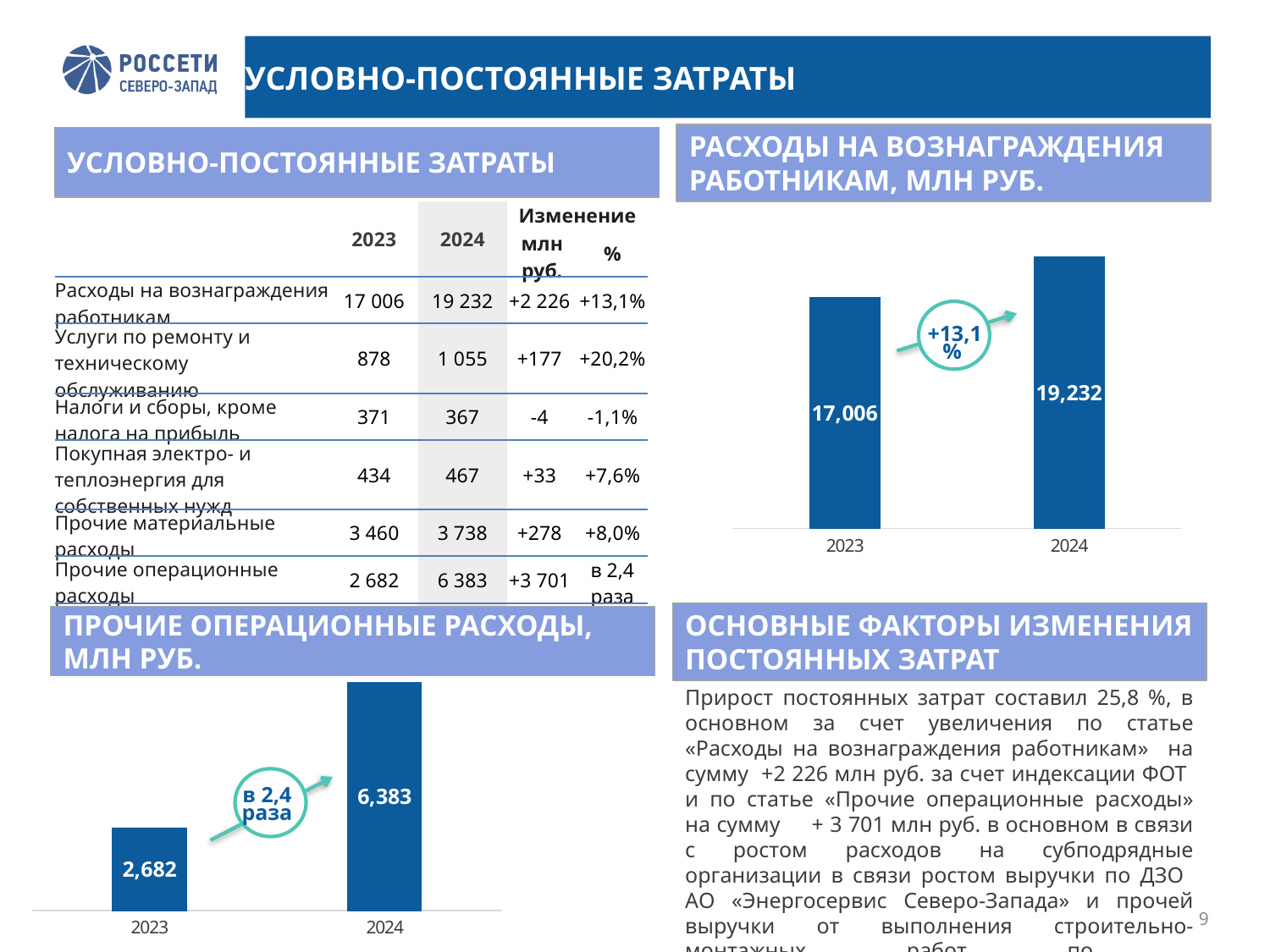
How many bars are shown in the chart titled 'РАСХОДЫ НА ВОЗНАГРАЖДЕНИЯ РАБОТНИКАМ, МЛН РУБ.'? 2 What kind of chart is the one titled 'ПРОЧИЕ ОПЕРАЦИОННЫЕ РАСХОДЫ, МЛН РУБ.'? bar chart In the chart titled 'РАСХОДЫ НА ВОЗНАГРАЖДЕНИЯ РАБОТНИКАМ, МЛН РУБ.', what percentage change is shown between 2023 and 2024? +13,1% In the chart titled 'РАСХОДЫ НА ВОЗНАГРАЖДЕНИЯ РАБОТНИКАМ, МЛН РУБ.', which year has the higher value? 2024 In the chart titled 'ПРОЧИЕ ОПЕРАЦИОННЫЕ РАСХОДЫ, МЛН РУБ.', what is the value for 2024? 6,383 In the chart titled 'РАСХОДЫ НА ВОЗНАГРАЖДЕНИЯ РАБОТНИКАМ, МЛН РУБ.', what is the difference between the 2024 and 2023 values? 2,226 In the chart titled 'РАСХОДЫ НА ВОЗНАГРАЖДЕНИЯ РАБОТНИКАМ, МЛН РУБ.', what is the value for 2024? 19,232 In the chart titled 'РАСХОДЫ НА ВОЗНАГРАЖДЕНИЯ РАБОТНИКАМ, МЛН РУБ.', what is the value for 2023? 17,006 In the chart titled 'ПРОЧИЕ ОПЕРАЦИОННЫЕ РАСХОДЫ, МЛН РУБ.', what is the difference between the 2024 and 2023 values? 3,701 In the chart titled 'ПРОЧИЕ ОПЕРАЦИОННЫЕ РАСХОДЫ, МЛН РУБ.', which year has the lower value? 2023 In the chart titled 'ПРОЧИЕ ОПЕРАЦИОННЫЕ РАСХОДЫ, МЛН РУБ.', what is the value for 2023? 2,682 In the chart titled 'ПРОЧИЕ ОПЕРАЦИОННЫЕ РАСХОДЫ, МЛН РУБ.', do the values rise or fall from 2023 to 2024? rise